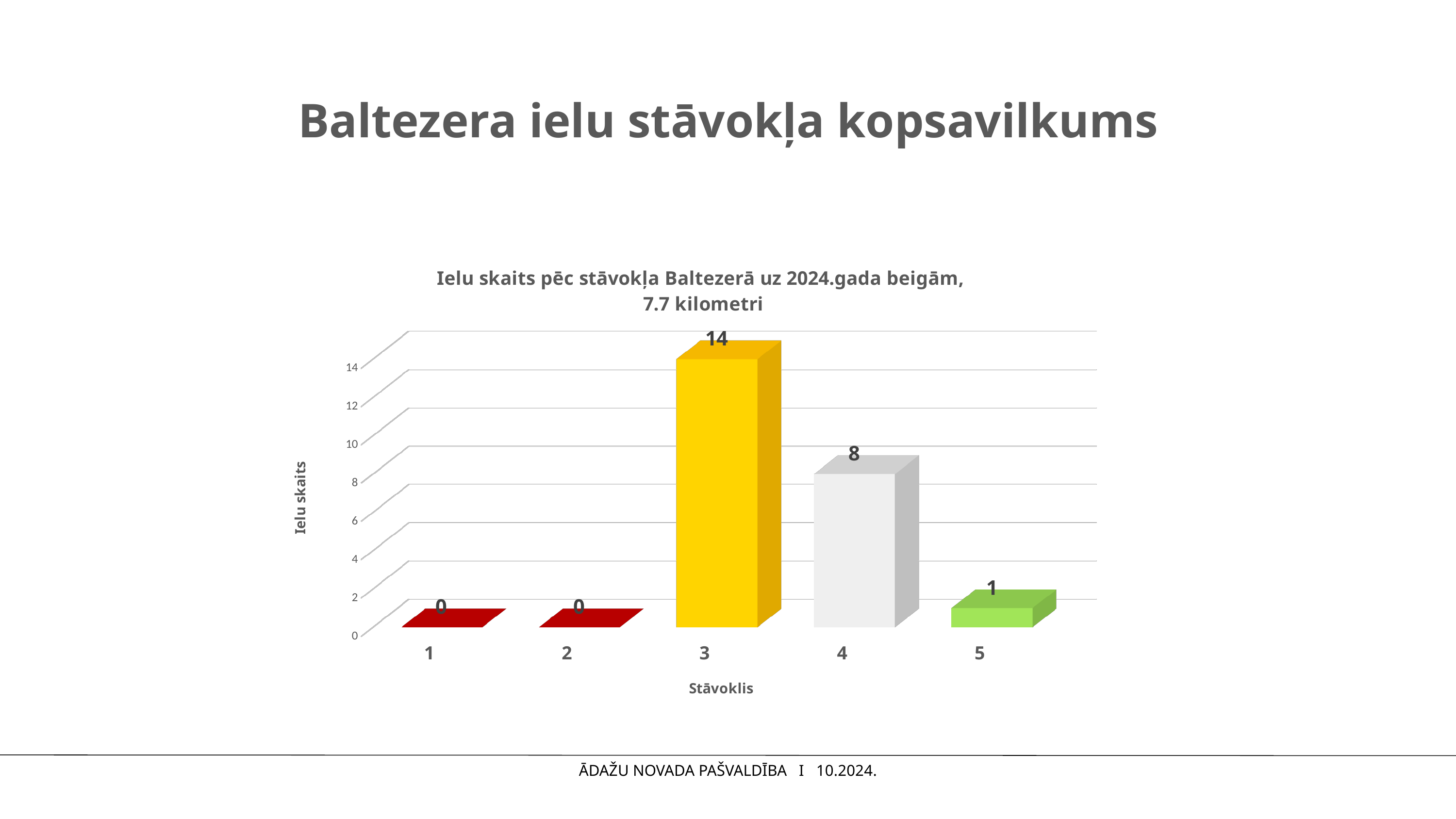
What is the total of all the values shown in the chart? 23 What kind of chart is shown on the slide? bar chart How many categories are shown on the x axis? 5 Which is larger, the value for category 4 or the value for category 5? 4 Which category has the highest value? 3 What is the value for category 5? 1 What is the label of the x axis? Stāvoklis What is the value for category 3? 14 What is the value for category 4? 8 What is the difference between the values for categories 3 and 4? 6 What is the title of the chart? Ielu skaits pēc stāvokļa Baltezerā uz 2024.gada beigām, 7.7 kilometri What is the value for category 1? 0